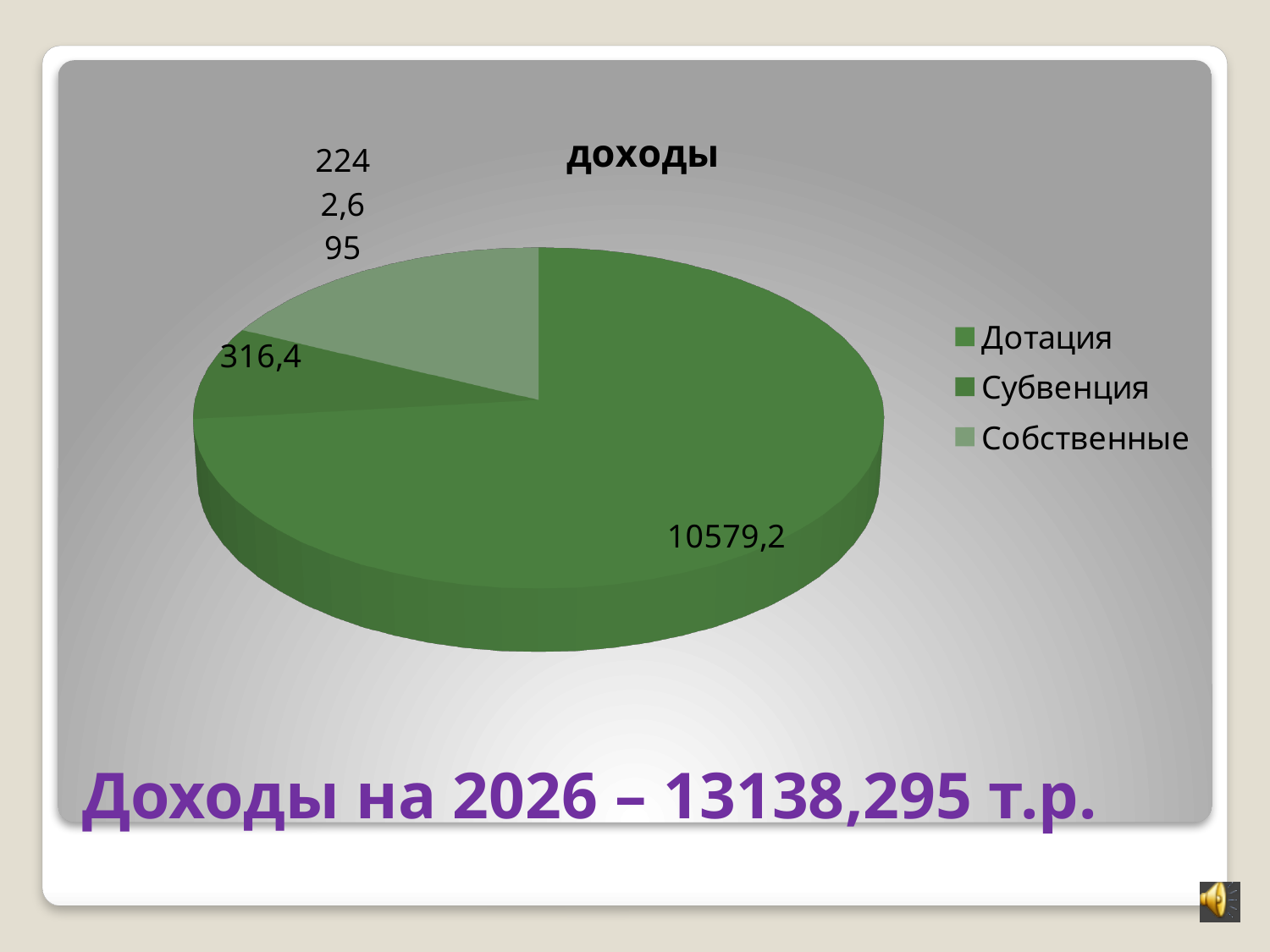
What is the value of the largest slice of the pie? 10579,2 Which category has the largest slice of the pie? Дотация What kind of chart is shown on the slide? pie chart Is the value for Дотация greater or less than 10000? greater What is the difference between the Дотация value (10579,2) and the Субвенция value (316,4)? 10262,8 What is the value shown for Дотация? 10579,2 Which is larger, the slice labelled 10579,2 or the slice labelled 316,4? 10579,2 According to the slide text, what is the total income (Доходы) for 2026? 13138,295 т.р. How many entries does the chart legend list? 3 What is the value shown for Субвенция? 316,4 What are the three categories listed in the chart legend? Дотация, Субвенция, Собственные What is the title of the chart? доходы